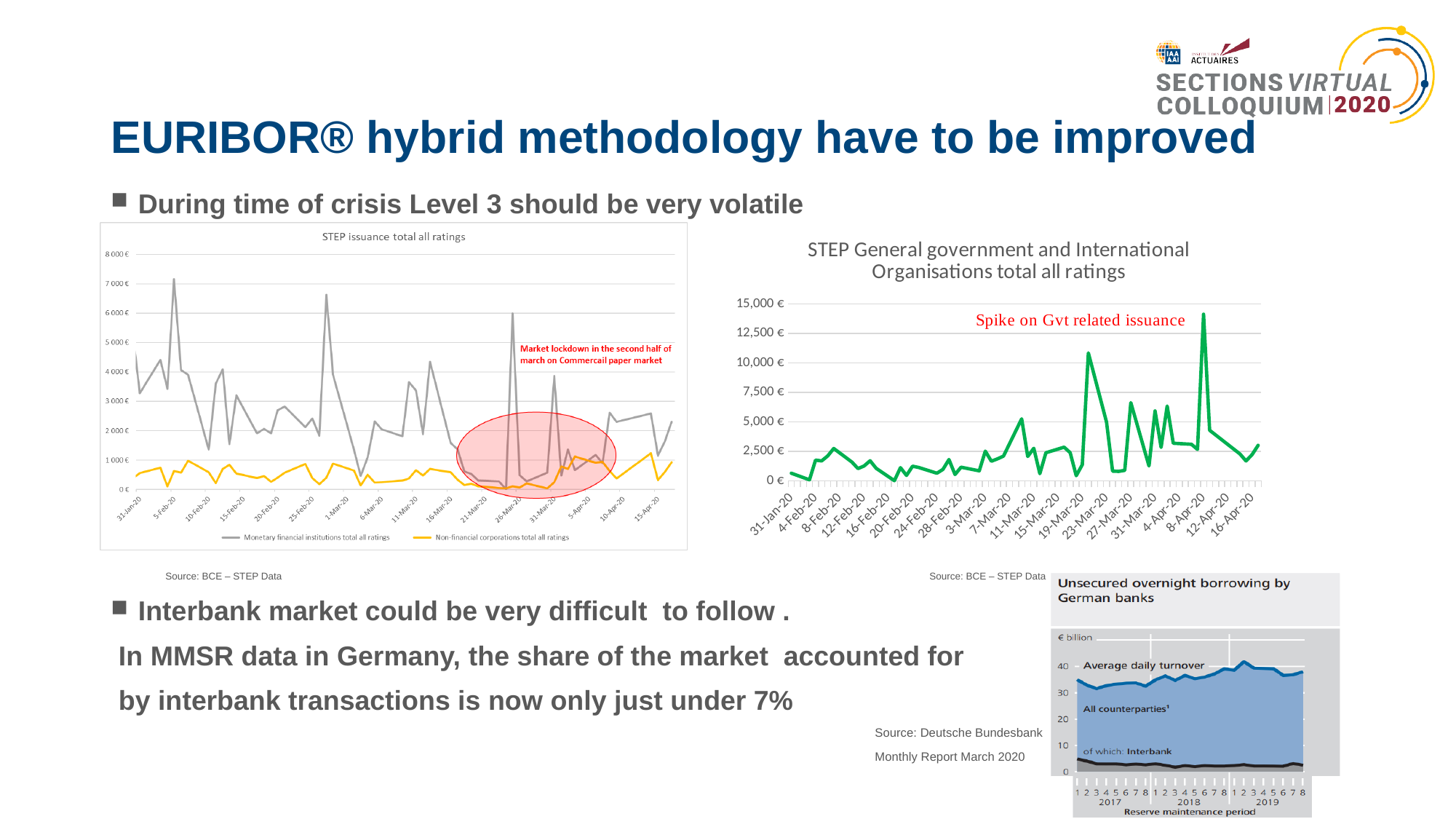
In the 'STEP General government and International Organisations total all ratings' chart, is the value on 31-Jan-20 greater or less than 2,500 €? less In the 'Unsecured overnight borrowing by German banks' chart, is the 'of which: Interbank' line greater or less than 10 € billion? less In the 'STEP General government and International Organisations total all ratings' chart, is the highest spike greater or less than 12,500 €? greater In the 'STEP issuance total all ratings' chart, which series is generally higher: Monetary financial institutions total all ratings or Non-financial corporations total all ratings? Monetary financial institutions total all ratings What colour is the line in the 'STEP General government and International Organisations total all ratings' chart? green In the 'STEP General government and International Organisations total all ratings' chart, around which date does the highest value occur? 8-Apr-20 How many series does the legend of the 'STEP issuance total all ratings' chart list? 2 What kind of chart is the 'STEP issuance total all ratings' chart? line chart What annotation text is written in red on the 'STEP General government and International Organisations total all ratings' chart? Spike on Gvt related issuance